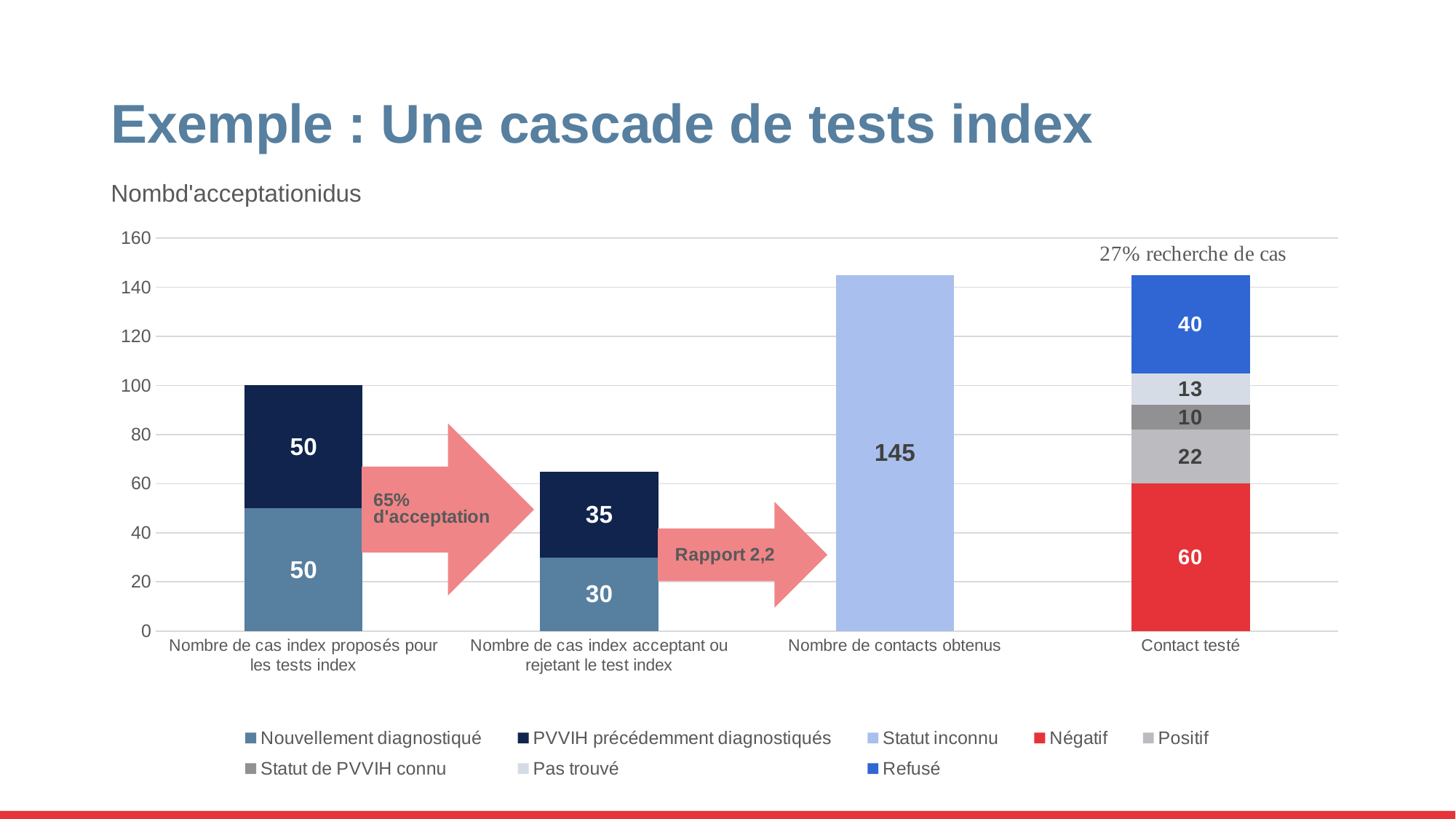
How many series does the legend list? 8 Which category has the lowest total bar height? Nombre de cas index acceptant ou rejetant le test index What is the total of the 'Contact testé' stacked bar? 145 What is the value for 'Négatif' in the 'Contact testé' bar? 60 What is the difference between the 'Négatif' and 'Positif' values in the 'Contact testé' bar? 38 What is the value for 'Nombre de contacts obtenus'? 145 What is the value for 'Refusé' in the 'Contact testé' bar? 40 How many categories are shown on the x axis? 4 What kind of chart is shown on the slide? stacked bar chart What is the value for 'PVVIH précédemment diagnostiqués' in the 'Nombre de cas index proposés pour les tests index' bar? 50 What is the total of the 'Nombre de cas index proposés pour les tests index' stacked bar? 100 What is the value for 'Nouvellement diagnostiqué' in the 'Nombre de cas index acceptant ou rejetant le test index' bar? 30